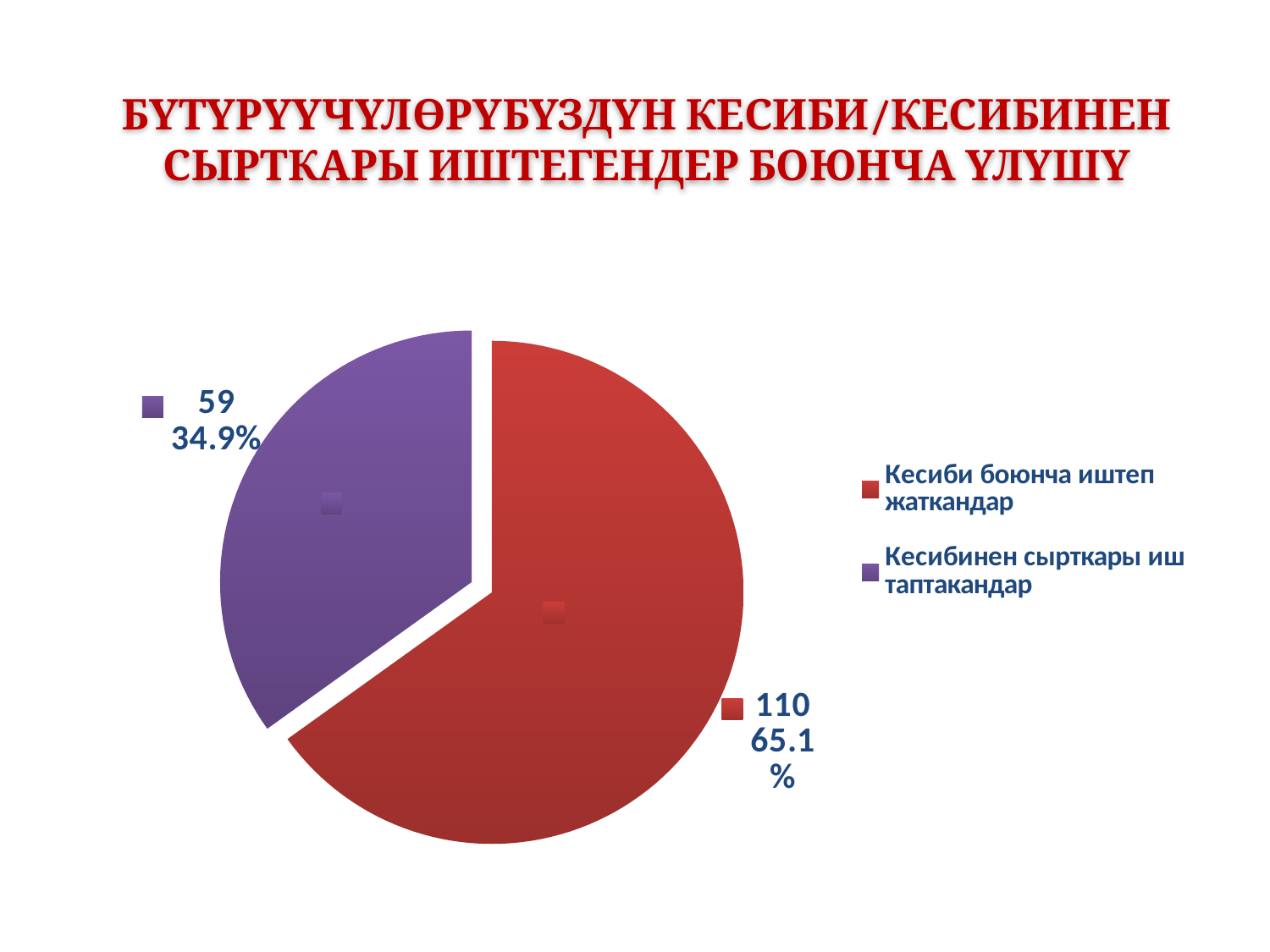
Which is larger: the value for "Кесиби боюнча иштеп жаткандар" or for "Кесибинен сырткары иш таптакандар"? Кесиби боюнча иштеп жаткандар What is the value for "Кесибинен сырткары иш таптакандар"? 59 What share of the pie does "Кесибинен сырткары иш таптакандар" represent? 34.9% Which category has the smallest slice? Кесибинен сырткары иш таптакандар How many entries does the legend list? 2 What is the difference between the values for "Кесиби боюнча иштеп жаткандар" and "Кесибинен сырткары иш таптакандар"? 51 What share of the pie does "Кесиби боюнча иштеп жаткандар" represent? 65.1% What is the value for "Кесиби боюнча иштеп жаткандар"? 110 How many slices does the pie chart have? 2 What colour is the slice for "Кесибинен сырткары иш таптакандар"? purple What kind of chart is shown on the slide? pie chart Which category has the largest slice? Кесиби боюнча иштеп жаткандар